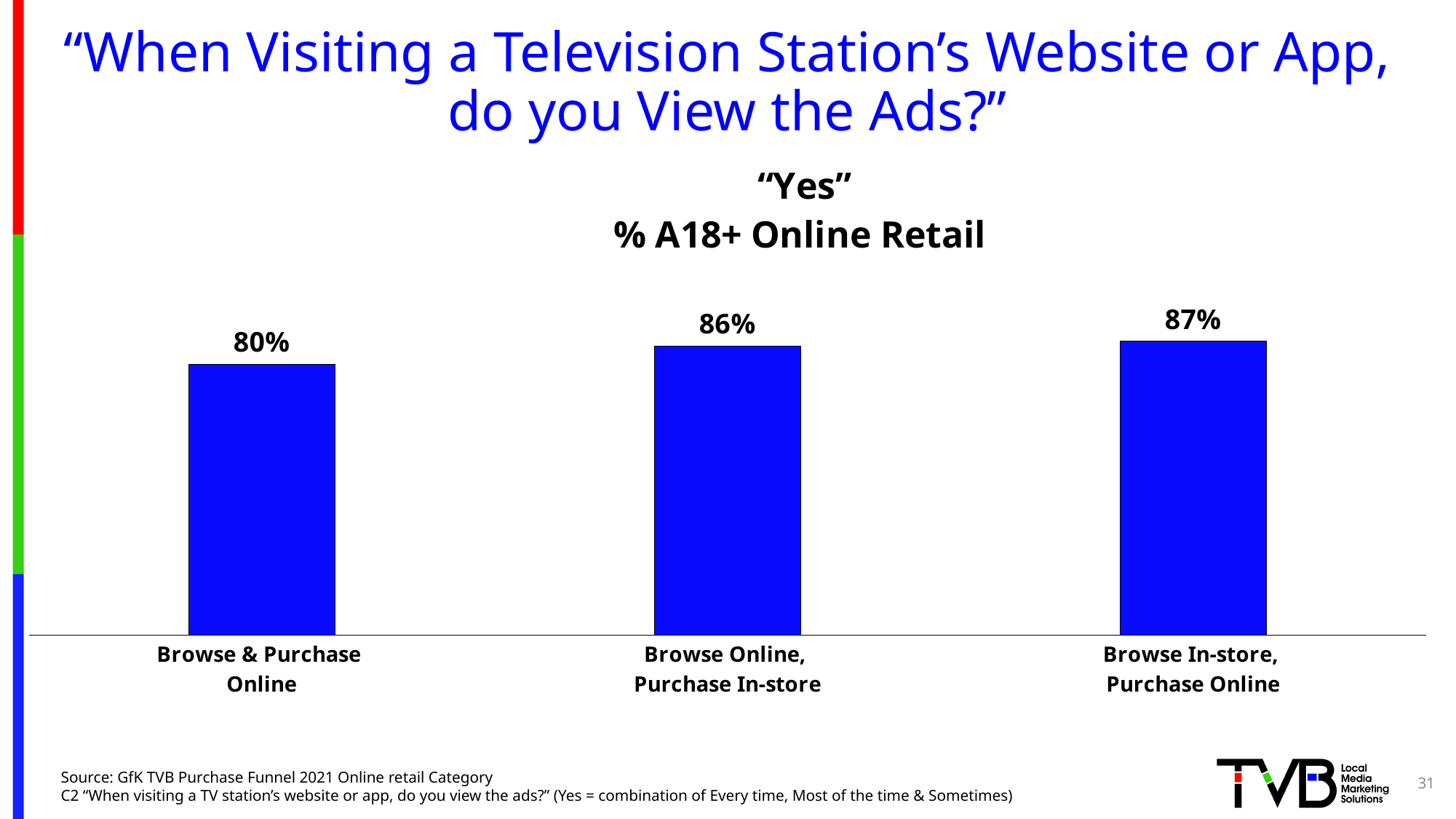
How many categories are shown in the chart? 3 Do the values rise or fall from left to right across the categories? Rise Which category has the lowest "Yes" percentage? Browse & Purchase Online What is the difference in percentage points between Browse In-store, Purchase Online and Browse & Purchase Online? 7 percentage points Which category has the highest "Yes" percentage? Browse In-store, Purchase Online What is the difference between Browse Online, Purchase In-store and Browse & Purchase Online? 6 percentage points What percentage of the Browse & Purchase Online group said "Yes" to viewing ads? 80% Which is larger: the value for Browse Online, Purchase In-store or the value for Browse & Purchase Online? Browse Online, Purchase In-store What is the value for Browse In-store, Purchase Online? 87% What is the value for Browse Online, Purchase In-store? 86% What type of chart is shown on the slide? Bar chart What is the chart's title? "Yes" % A18+ Online Retail